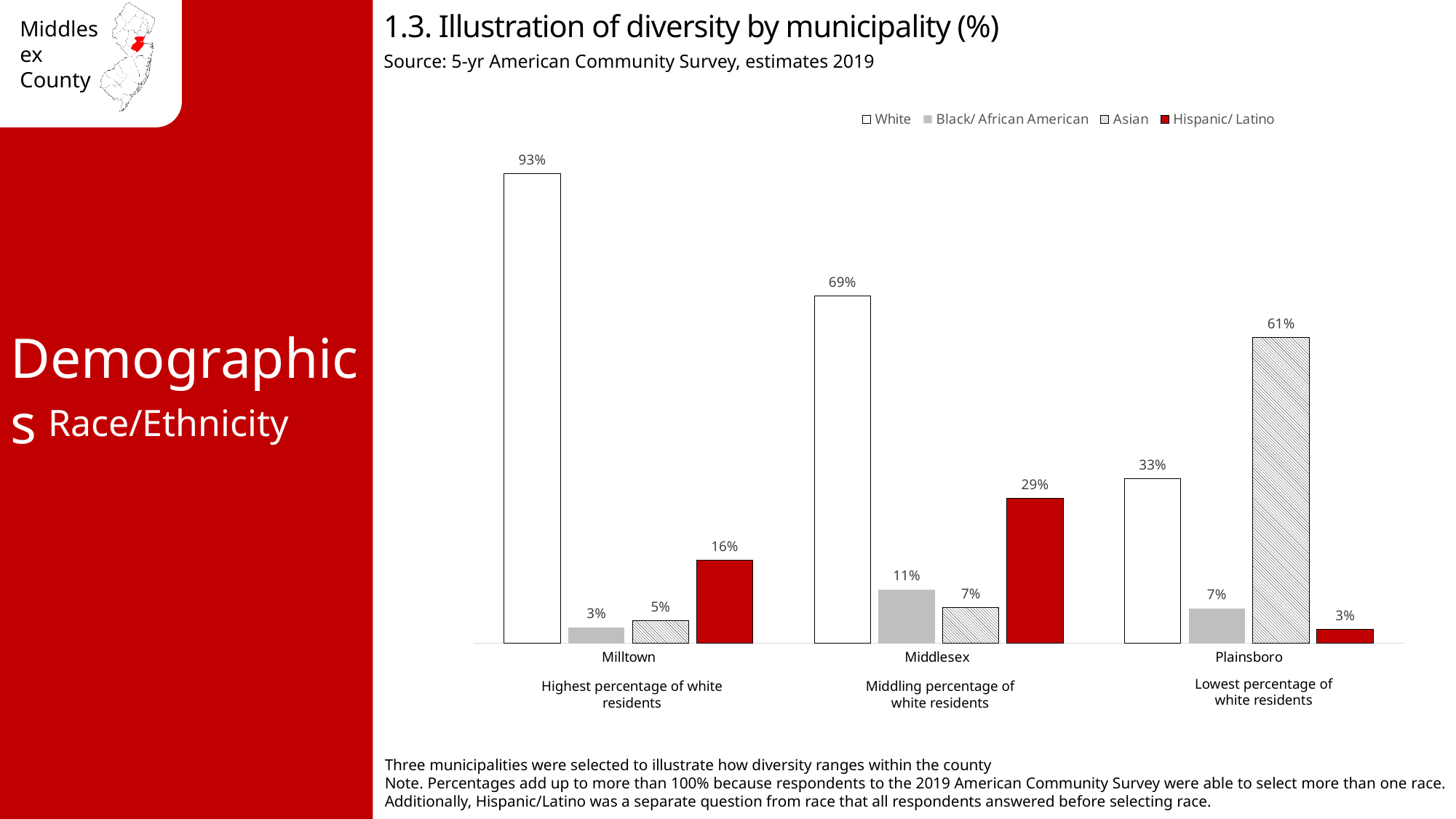
Which municipality has the highest White percentage? Milltown What kind of chart is shown on the slide? Bar chart What is the difference between the White percentage in Milltown and in Plainsboro? 60% Which municipality has the lowest Hispanic/ Latino percentage? Plainsboro Which series is shown in red in the legend? Hispanic/ Latino What is the Asian percentage for Plainsboro? 61% How many series does the legend list? 4 What is the White percentage for Milltown? 93% How many municipalities are shown on the x axis? 3 What is the Black/ African American percentage for Middlesex? 11% Which is larger: the Asian percentage in Plainsboro or the White percentage in Plainsboro? Asian What is the Hispanic/ Latino percentage for Middlesex? 29%